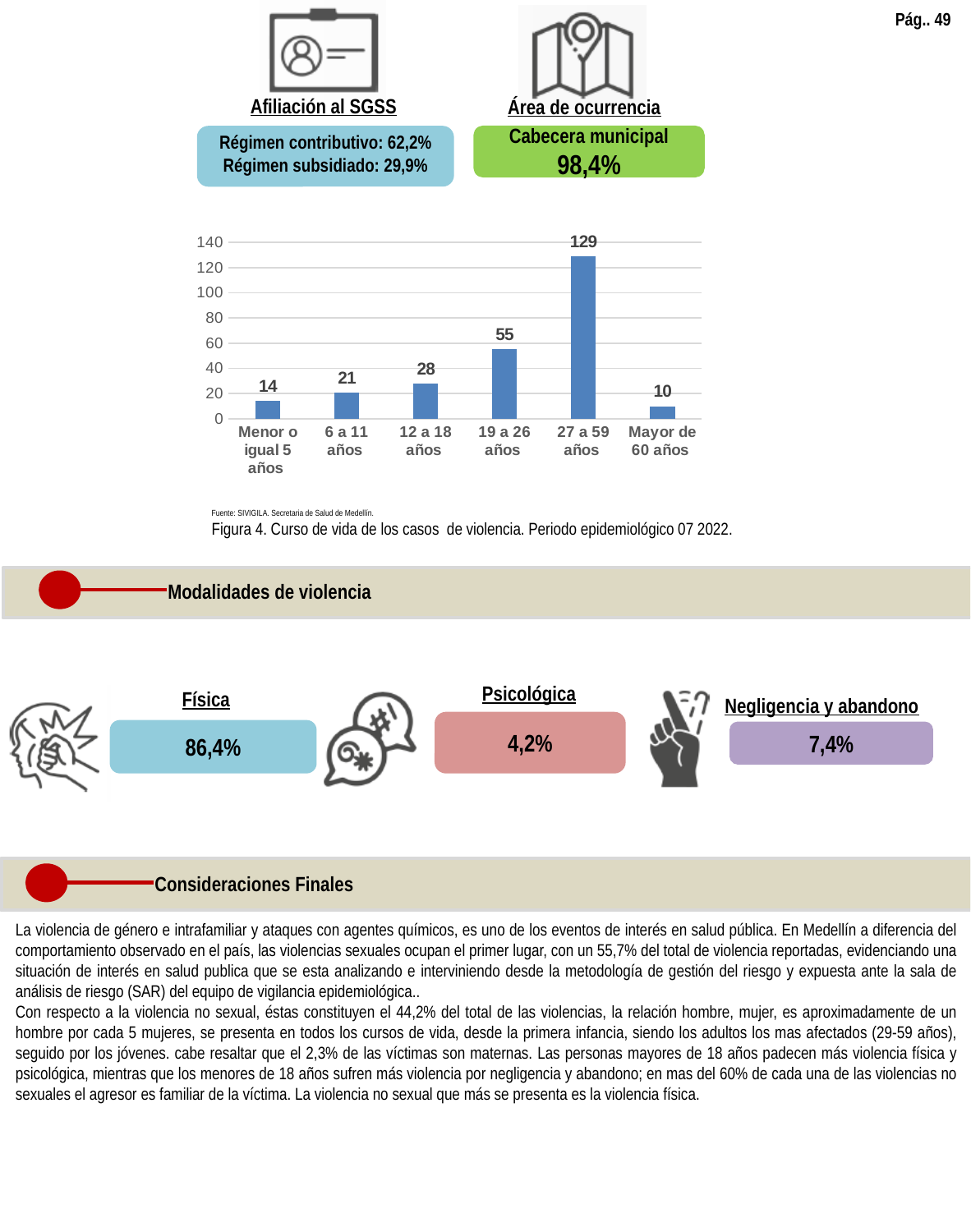
Is the value for '27 a 59 años' greater or less than 100? greater What is the value for the 'Menor o igual 5 años' category in the bar chart? 14 What is the value for the '19 a 26 años' category in the bar chart? 55 Which age group has the highest value in the bar chart? 27 a 59 años What is the difference between the values for '27 a 59 años' and '19 a 26 años'? 74 How many age categories are shown in the bar chart? 6 What is the value for the '27 a 59 años' category in the bar chart? 129 What kind of chart is Figura 4? bar chart Which is larger, the value for '6 a 11 años' or the value for 'Mayor de 60 años'? 6 a 11 años What is the difference between the values for '12 a 18 años' and '6 a 11 años'? 7 What is the caption of the chart shown on the slide? Figura 4. Curso de vida de los casos de violencia. Periodo epidemiológico 07 2022. Which age group has the lowest value in the bar chart? Mayor de 60 años